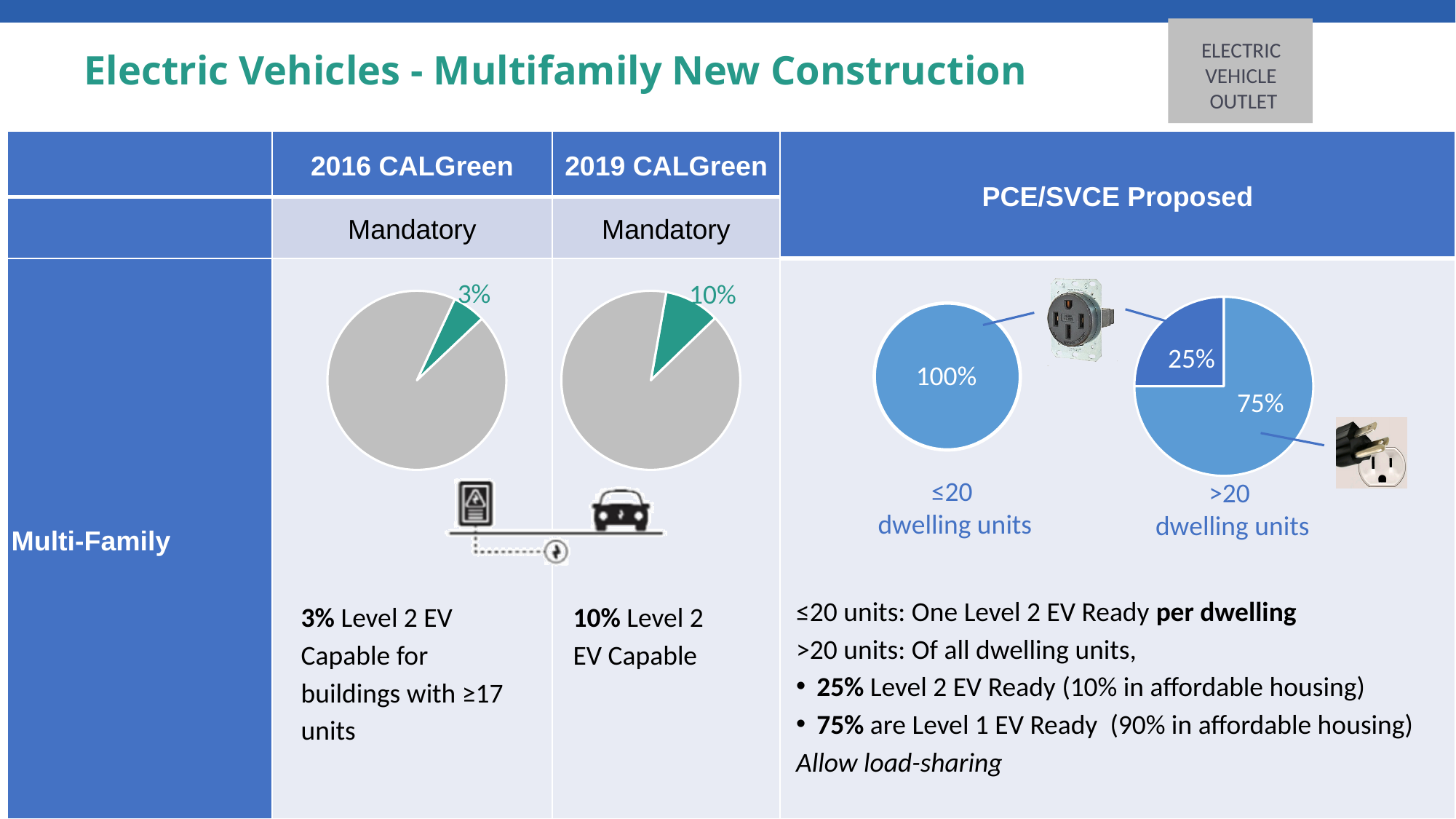
How many slices does the PCE/SVCE Proposed pie chart for >20 dwelling units have? 2 What is the difference between the green slice in the 2019 CALGreen pie chart and the green slice in the 2016 CALGreen pie chart? 7% What kind of charts are shown on the slide? Pie charts In the PCE/SVCE Proposed pie chart for >20 dwelling units, what is the difference between the 75% slice and the 25% slice? 50% In the PCE/SVCE Proposed pie chart for ≤20 dwelling units, what percentage is labelled? 100% In the 2016 CALGreen pie chart, what share is labelled on the green slice? 3% How many pie charts are on the slide? 4 In the PCE/SVCE Proposed pie chart for >20 dwelling units, what share is labelled on the dark blue slice? 25% In the PCE/SVCE Proposed pie chart for >20 dwelling units, what share is labelled on the light blue slice? 75% Which has the larger green slice, the 2016 CALGreen pie chart or the 2019 CALGreen pie chart? 2019 CALGreen What colour is the 3% slice in the 2016 CALGreen pie chart? Green